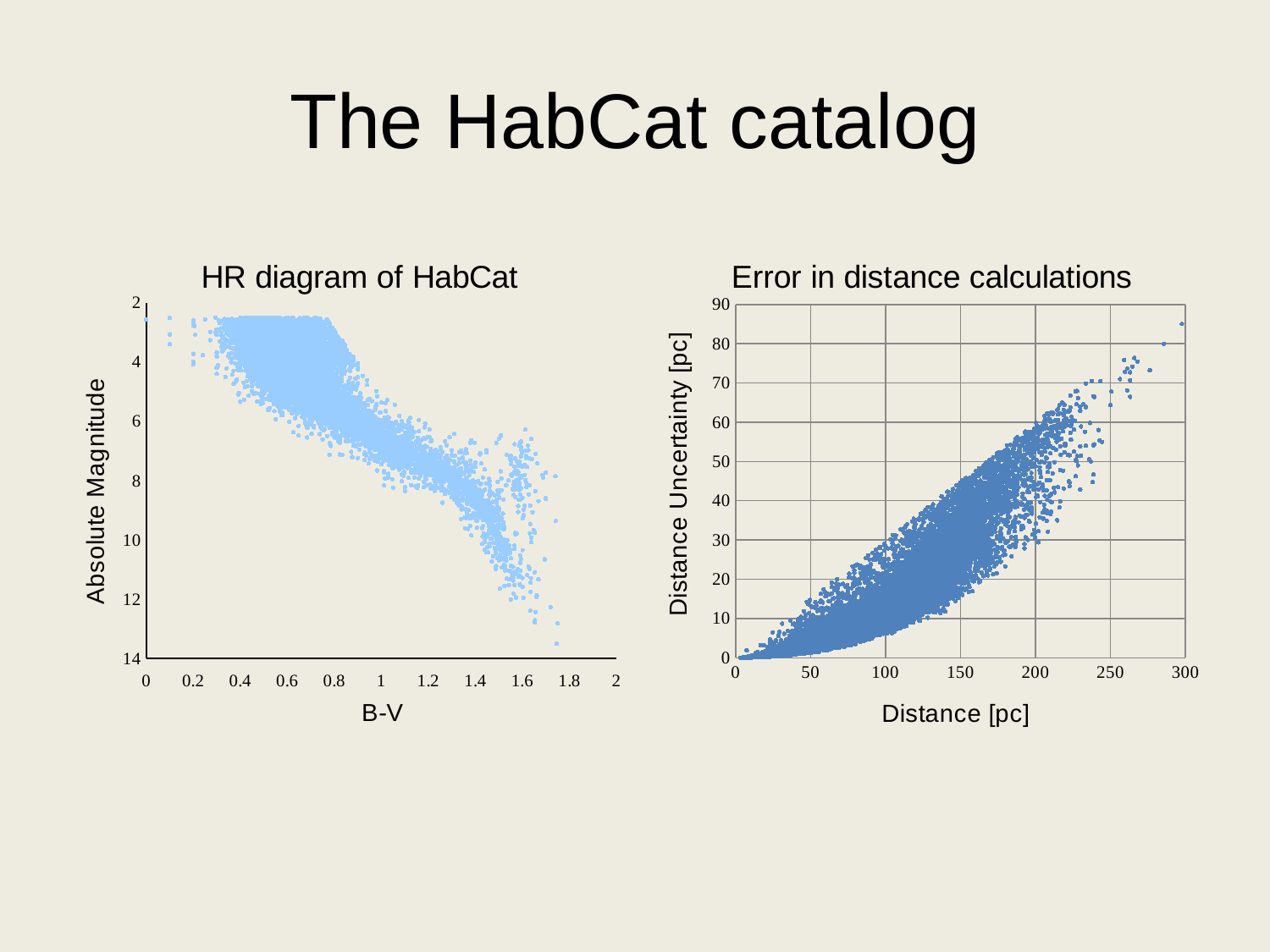
In the 'HR diagram of HabCat' chart, what is the label of the x axis? B-V In the 'HR diagram of HabCat' chart, what is the largest value shown on the y axis? 14 In the 'Error in distance calculations' chart, is the highest distance uncertainty plotted greater or less than 80? greater In the 'Error in distance calculations' chart, what is the highest value shown on the x axis? 300 In the 'HR diagram of HabCat' chart, is the largest B-V value plotted greater or less than 1.6? greater In the 'Error in distance calculations' chart, what is the label of the y axis? Distance Uncertainty [pc] In the 'Error in distance calculations' chart, does distance uncertainty rise or fall as distance increases? rise What kind of chart is the 'HR diagram of HabCat' chart? scatter chart What kind of chart is the 'Error in distance calculations' chart? scatter chart